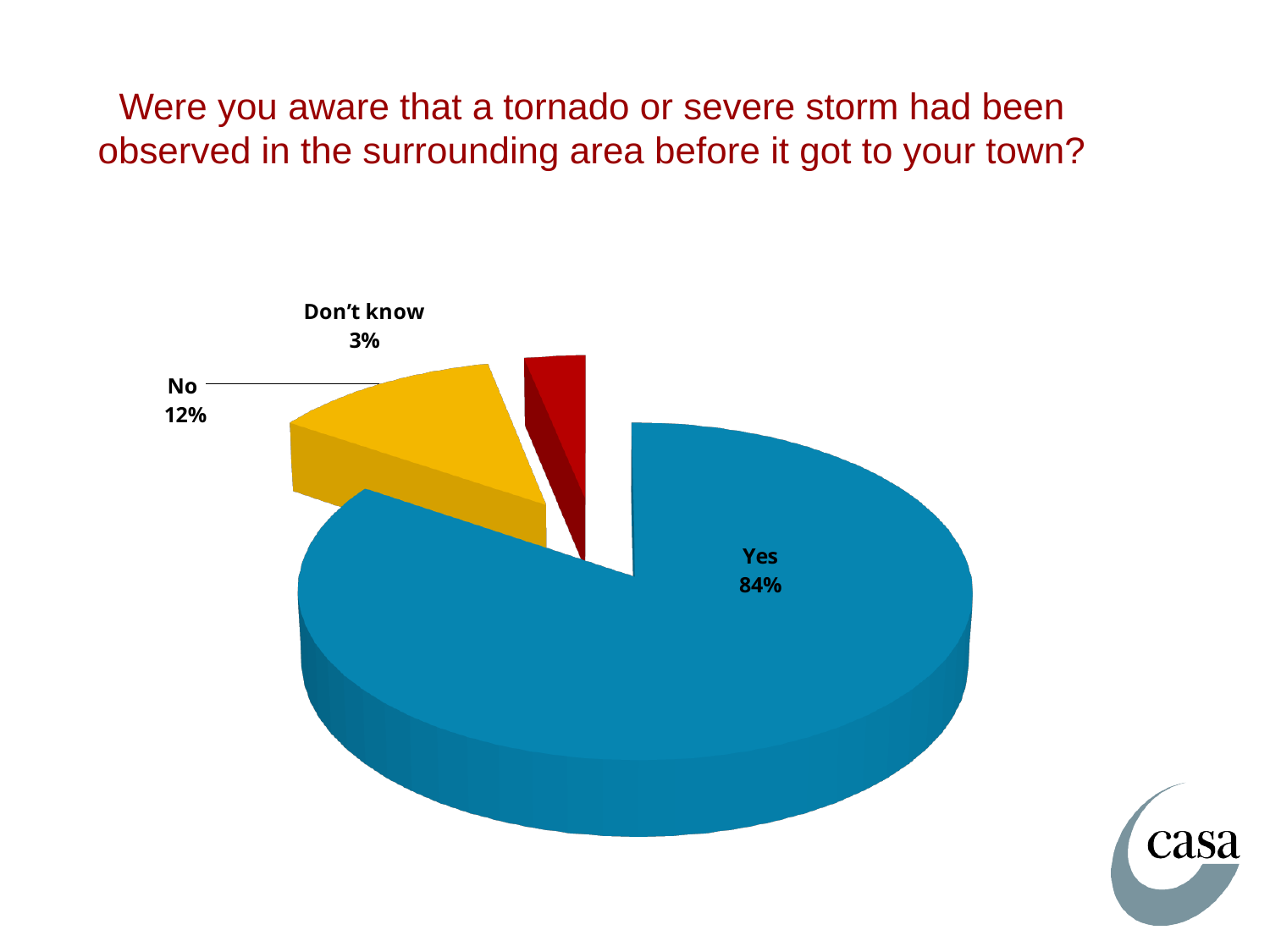
Which is larger, the share for "No" or the share for "Don't know"? No What colour is the "No" slice of the pie? Yellow Which response has the largest share of the pie? Yes How many slices does the pie chart have? 3 Which response has the smallest share of the pie? Don't know What is the difference in percentage points between the "Yes" and "No" responses? 72 What percentage of respondents answered "No"? 12% What percentage of respondents answered "Yes"? 84% What kind of chart is shown on the slide? Pie chart What colour is the "Yes" slice of the pie? Blue What is the difference in percentage points between the "No" and "Don't know" responses? 9 What percentage of respondents answered "Don't know"? 3%